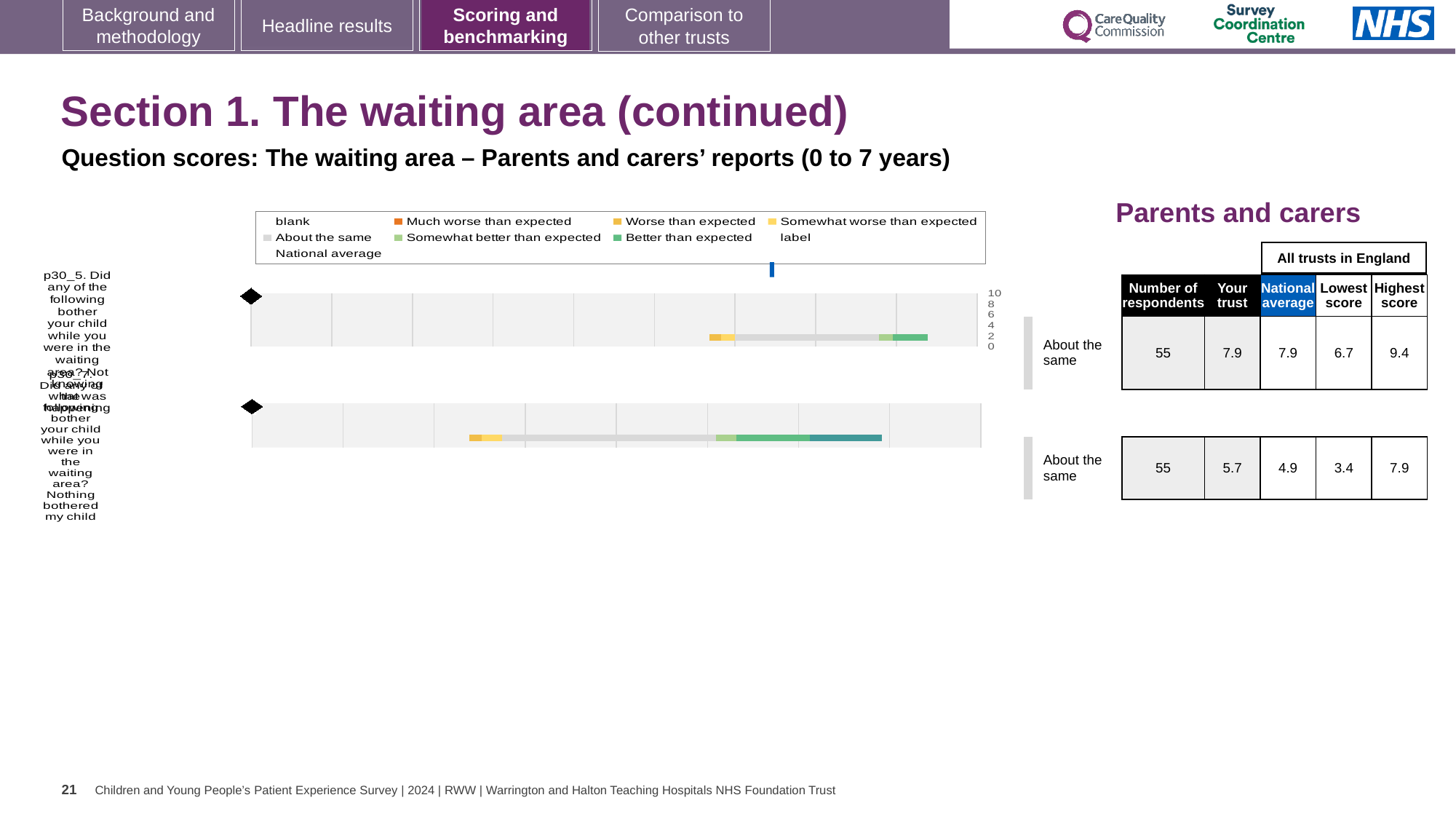
For the bottom chart (p30_7, Nothing bothered my child), what is the difference between the 'Your trust' score and the national average? 0.8 For the bottom chart (p30_7, Nothing bothered my child), what is the national average score? 4.9 For the top chart (p30_5, Not knowing what was happening), what is the lowest score among all trusts in England? 6.7 What benchmark category is shown next to the top chart (p30_5, Not knowing what was happening)? About the same What kind of chart is used on this slide to show the question scores? Bar chart How many question charts (bars) are plotted on the slide? 2 For the top chart (p30_5, Not knowing what was happening), what is the 'Your trust' score shown in the table? 7.9 How many respondents are reported for the bottom chart (p30_7, Nothing bothered my child)? 55 In the chart legend, what does the dark blue marker represent? National average For the top chart (p30_5, Not knowing what was happening), what is the highest score among all trusts in England? 9.4 Which chart has the higher 'Your trust' score, the top chart (p30_5) or the bottom chart (p30_7)? The top chart (p30_5) For the bottom chart (p30_7, Nothing bothered my child), what is the 'Your trust' score shown in the table? 5.7